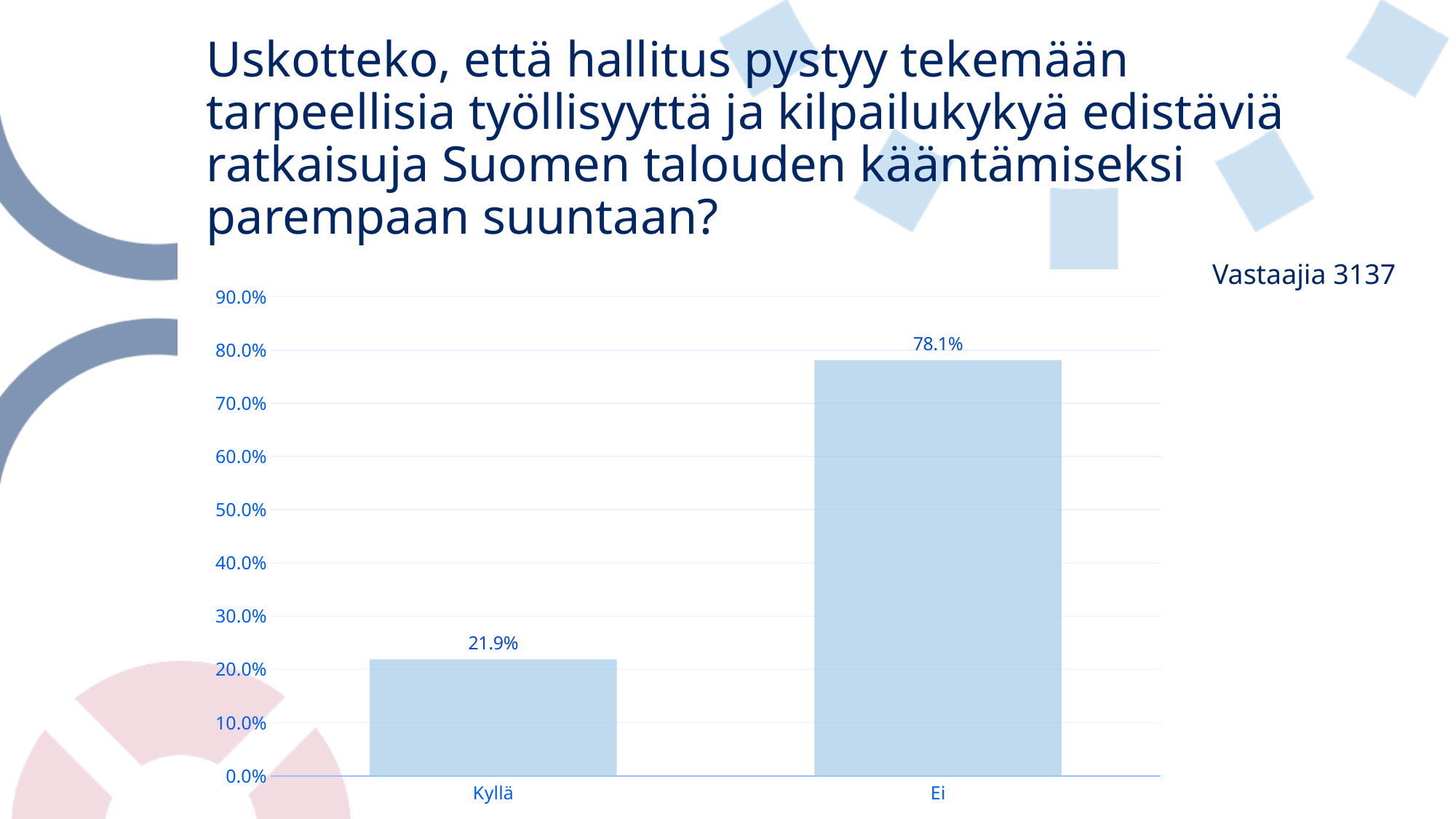
What is the total of the two bar values? 100.0% How many respondents (Vastaajia) are indicated on the slide? 3137 Is the value for Kyllä greater or less than 30.0%? less What is the value for Kyllä? 21.9% Which category has the lowest value? Kyllä What is the value for Ei? 78.1% Is the value for Ei greater or less than 70.0%? greater What kind of chart is shown on the slide? bar chart How many categories are shown on the x axis? 2 Which category has the highest value? Ei Which is larger, the value for Kyllä or the value for Ei? Ei What is the difference between the values for Ei and Kyllä? 56.2%